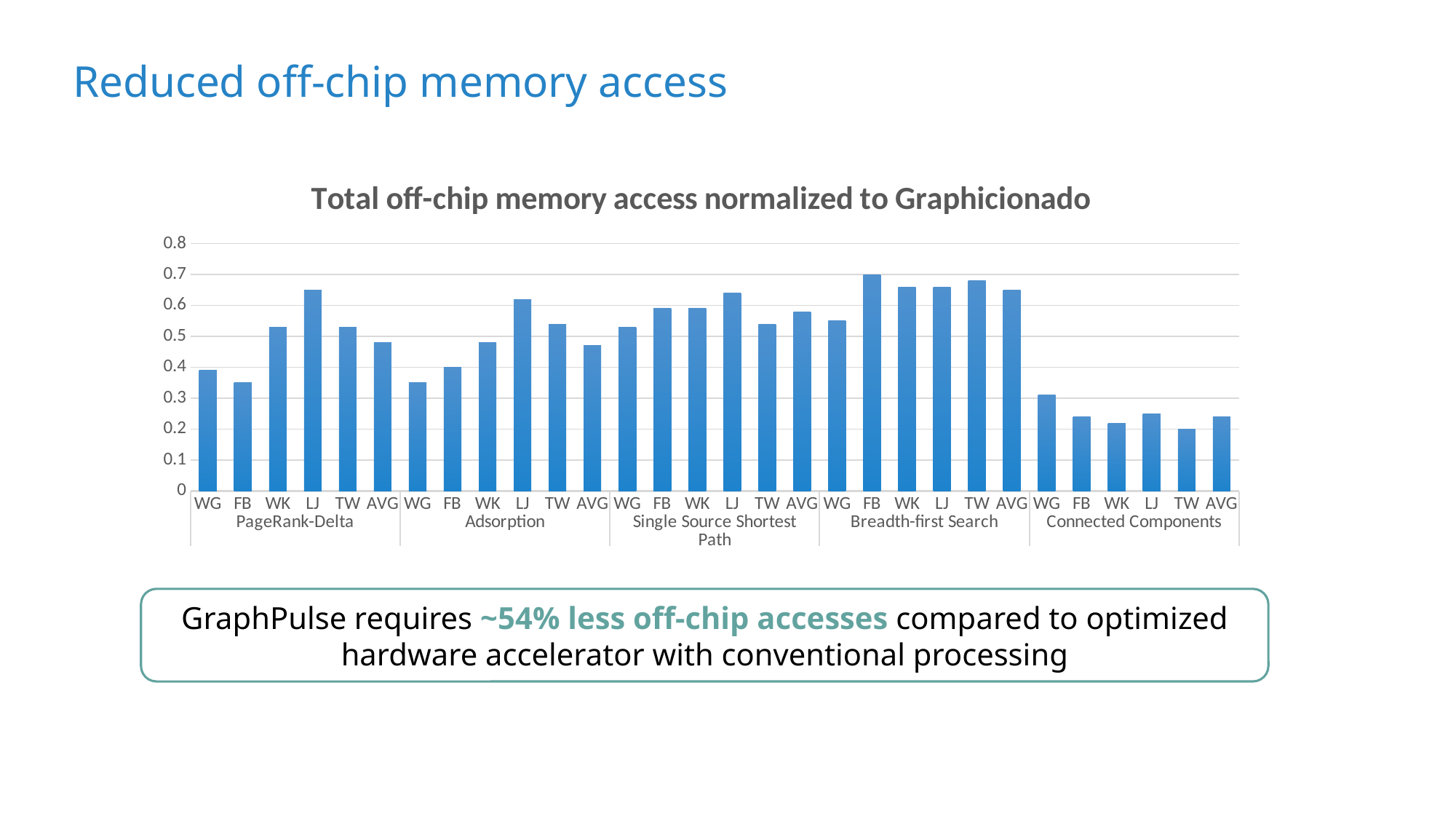
Within the PageRank-Delta group, which input has the lowest bar? FB What is the title of the chart? Total off-chip memory access normalized to Graphicionado Is the value for WG in the Connected Components group greater or less than 0.4? less How many bars are plotted in the chart in total? 30 Which algorithm group has the highest bars overall in the chart? Breadth-first Search Within the Breadth-first Search group, which input has the highest bar? FB Which is larger: the AVG bar for Single Source Shortest Path or the AVG bar for Adsorption? Single Source Shortest Path Within the Connected Components group, which input has the lowest bar? TW Is the value for LJ in the PageRank-Delta group greater or less than 0.6? greater Which algorithm group has the lowest bars overall in the chart? Connected Components What kind of chart is shown on the slide? bar chart How many algorithm groups are shown along the x axis of the chart? 5